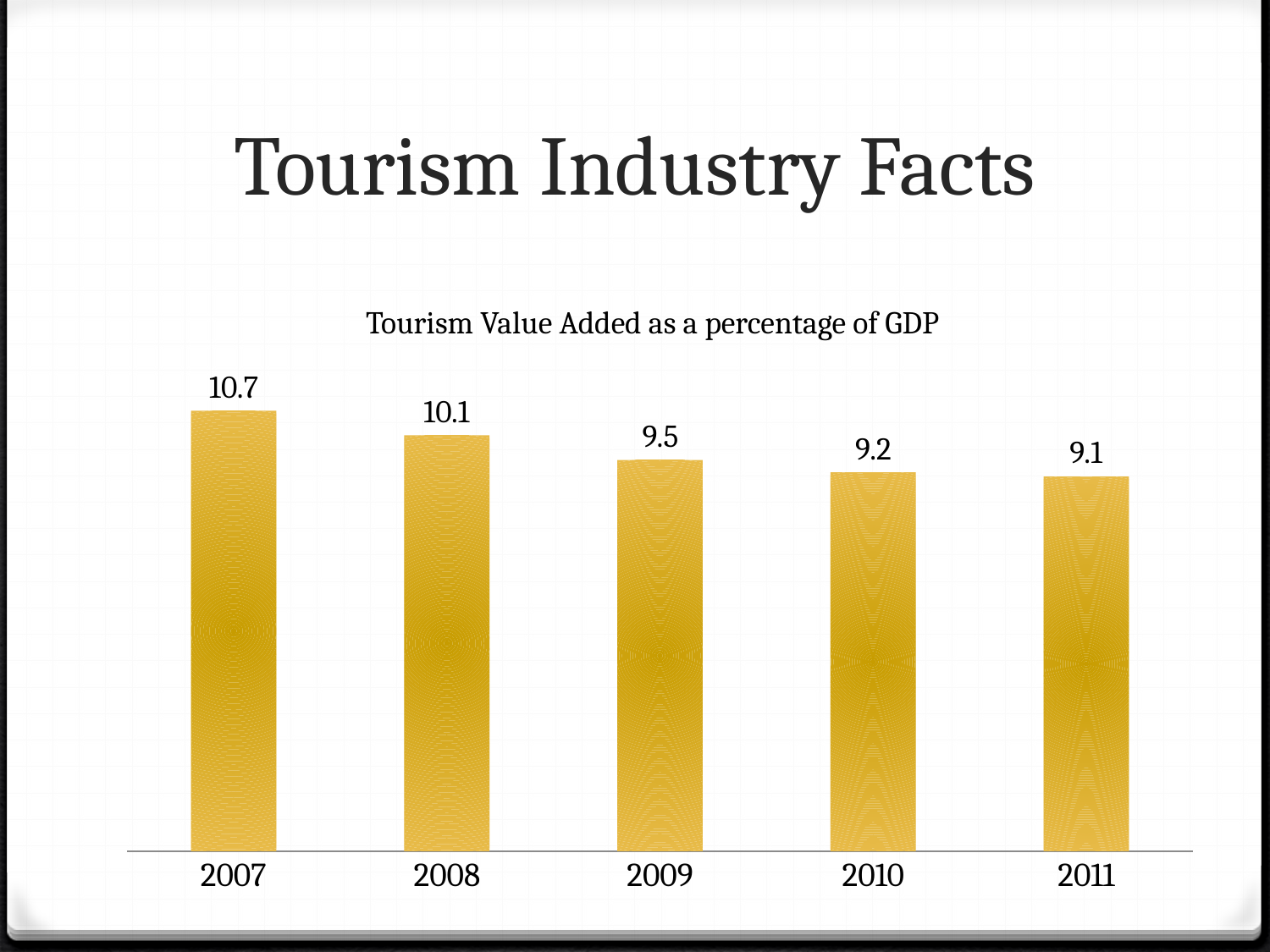
What is the difference between the values for 2008 and 2009? 0.6 What is the value for 2011? 9.1 Which year has the lowest value? 2011 What kind of chart is this? bar chart What is the title of the chart? Tourism Value Added as a percentage of GDP What is the difference between the values for 2007 and 2011? 1.6 What is the value for 2009? 9.5 Which year has the highest value? 2007 What is the value for 2007? 10.7 How many years are shown on the chart? 5 Which is larger, the value for 2008 or the value for 2010? 2008 Do the values rise or fall from 2007 to 2011? fall